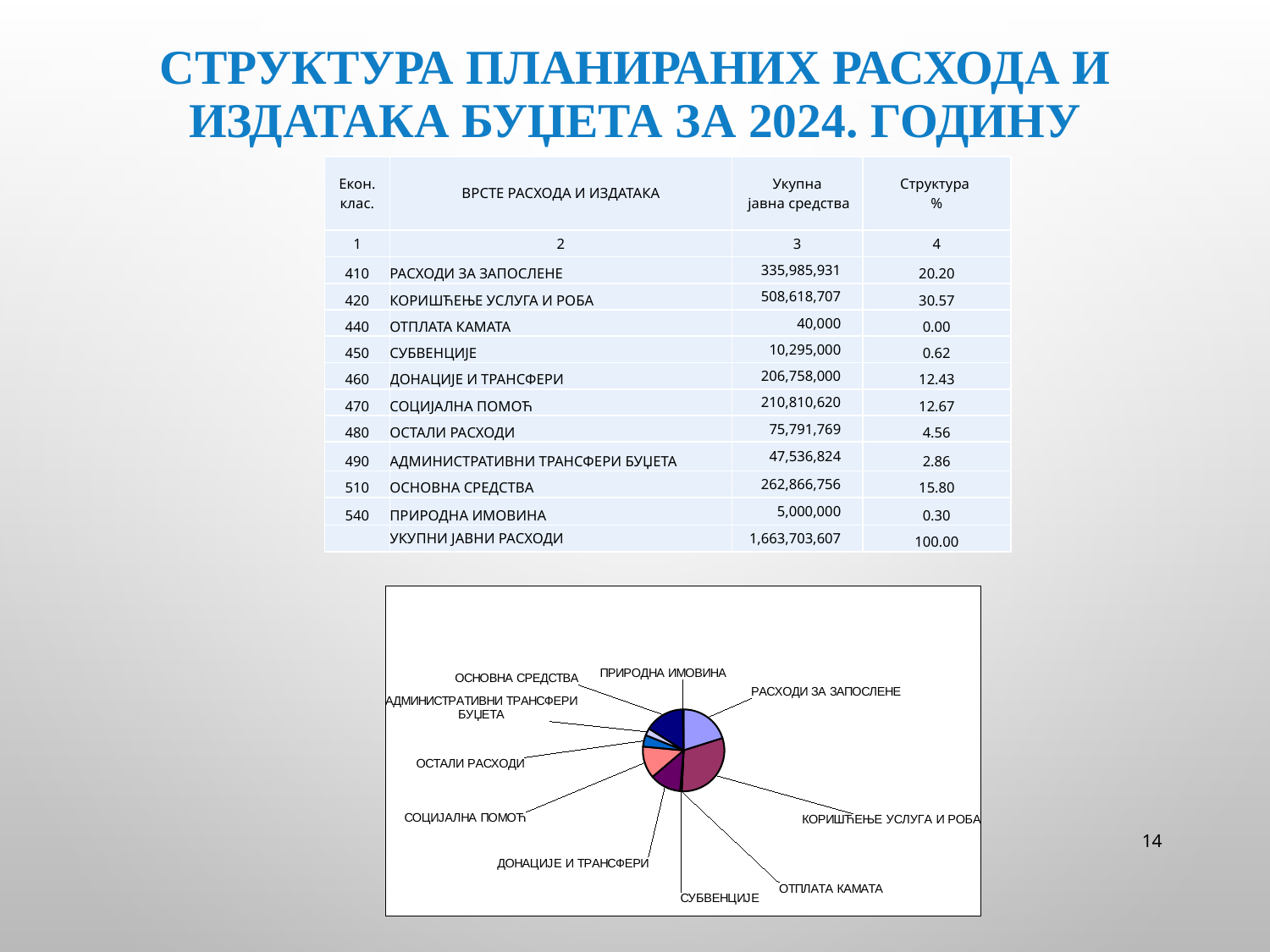
Which category label appears at the top of the pie chart, directly above the pie? ПРИРОДНА ИМОВИНА What is the total УКУПНИ ЈАВНИ РАСХОДИ shown in the table on the slide? 1,663,703,607 What is the value of Укупна јавна средства for ОСНОВНА СРЕДСТВА in the table on the slide? 262,866,756 What share of the pie does РАСХОДИ ЗА ЗАПОСЛЕНЕ represent, according to the table on the slide? 20.20 Which category has the smallest share according to the table above the pie chart? ОТПЛАТА КАМАТА How many categories (slices) does the pie chart have? 10 What is the difference in Структура % between ДОНАЦИЈЕ И ТРАНСФЕРИ and СОЦИЈАЛНА ПОМОЋ in the table? 0.24 What share of the pie does КОРИШЋЕЊЕ УСЛУГА И РОБА represent, according to the table on the slide? 30.57 Which slice is larger in the pie chart: КОРИШЋЕЊЕ УСЛУГА И РОБА or СОЦИЈАЛНА ПОМОЋ? КОРИШЋЕЊЕ УСЛУГА И РОБА Which slice is larger in the pie chart: РАСХОДИ ЗА ЗАПОСЛЕНЕ or ОСНОВНА СРЕДСТВА? РАСХОДИ ЗА ЗАПОСЛЕНЕ What kind of chart is shown on the slide? pie chart Which category has the largest slice in the pie chart? КОРИШЋЕЊЕ УСЛУГА И РОБА